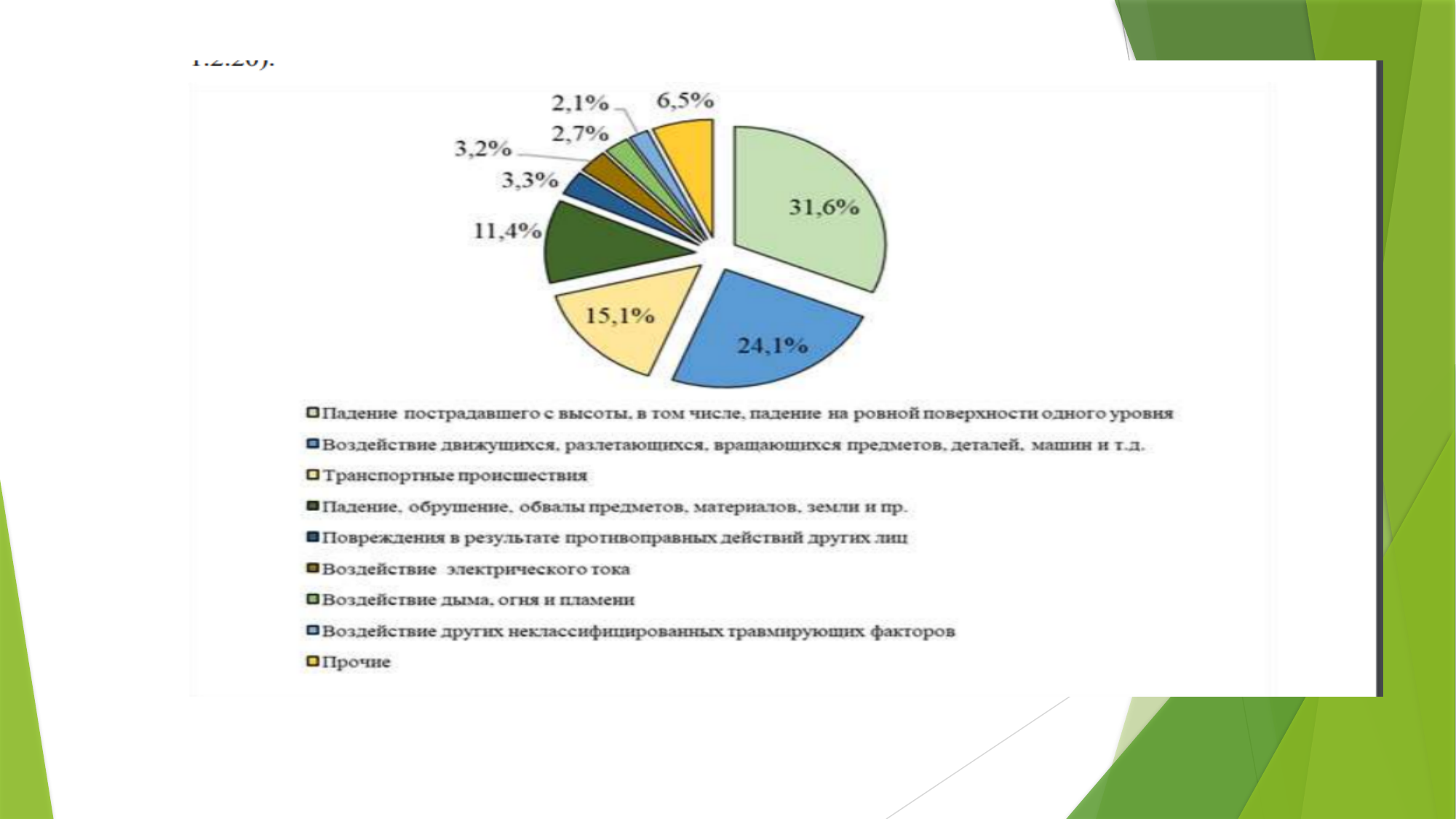
What percentage is shown for "Прочие"? 6,5% What is the difference in percentage points between the 31,6% slice and the 24,1% slice? 7,5 What percentage is shown for "Воздействие электрического тока"? 3,2% Which category has the smallest slice of the pie? Воздействие других неклассифицированных травмирующих факторов What percentage is shown for "Падение пострадавшего с высоты, в том числе, падение на ровной поверхности одного уровня"? 31,6% How many slices does the pie chart have? 9 What percentage is shown for "Воздействие движущихся, разлетающихся, вращающихся предметов, деталей, машин и т.д."? 24,1% What kind of chart is shown on the slide? pie chart What share of the pie is labelled for "Транспортные происшествия"? 15,1% Which category has the largest slice of the pie? Падение пострадавшего с высоты, в том числе, падение на ровной поверхности одного уровня What colour is the slice for "Воздействие дыма, огня и пламени"? green Which is larger: the share for "Падение, обрушение, обвалы предметов, материалов, земли и пр." or the share for "Прочие"? Падение, обрушение, обвалы предметов, материалов, земли и пр.